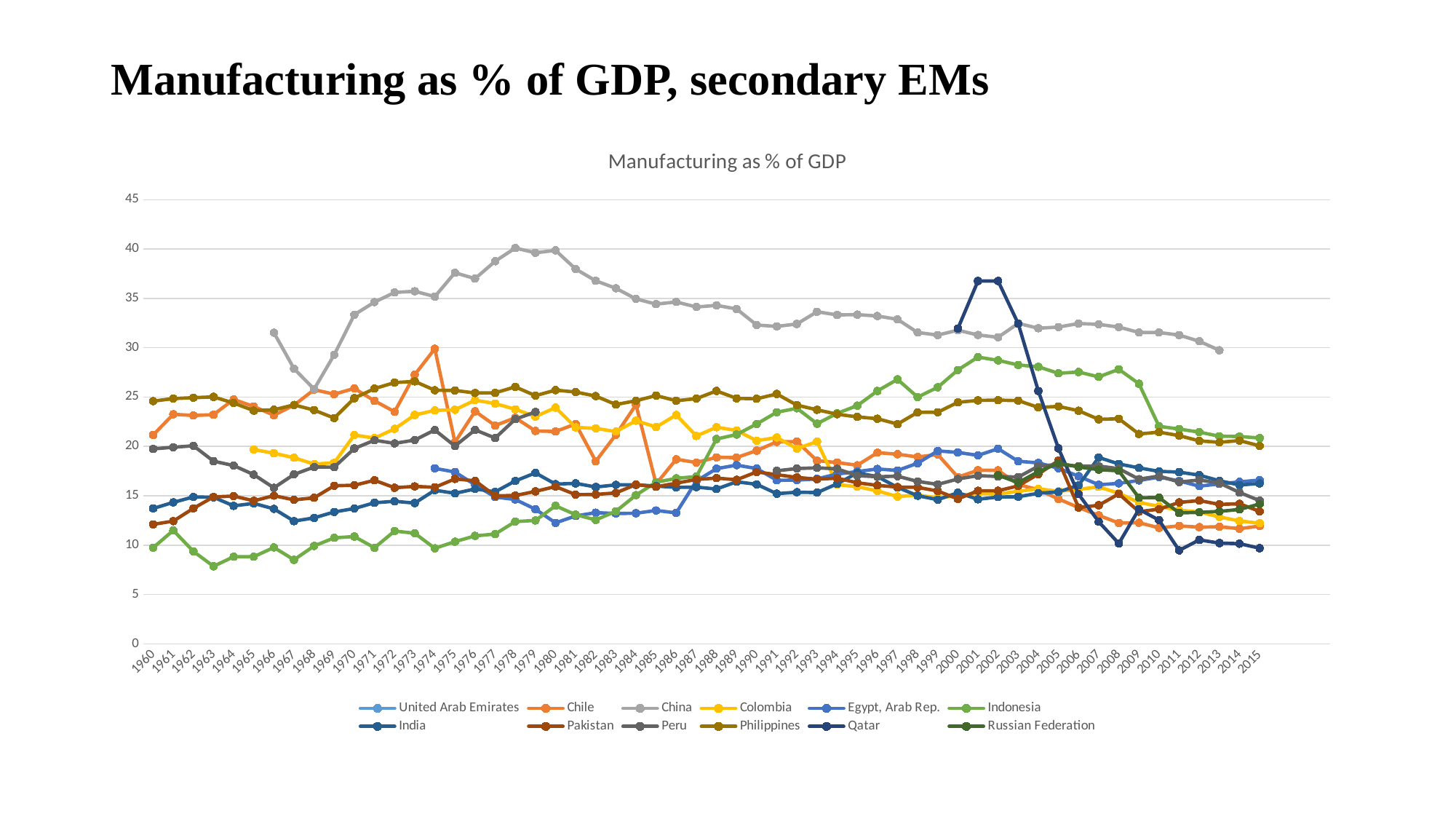
Does the value for China rise or fall overall from 1978 to 2013? fall What kind of chart is shown on the slide? line chart Is the value for Philippines in 1960 greater or less than 20? greater Is the value for Qatar in 2001 greater or less than 35? greater How many series does the legend list? 12 Is the value for China in 1978 greater or less than 35? greater Which series has the highest value in 1978? China Which series has the lowest value in 1963? Indonesia How many years are shown along the x axis? 56 In 2015, which is larger: the value for Indonesia or the value for Pakistan? Indonesia What is the title of the chart? Manufacturing as % of GDP